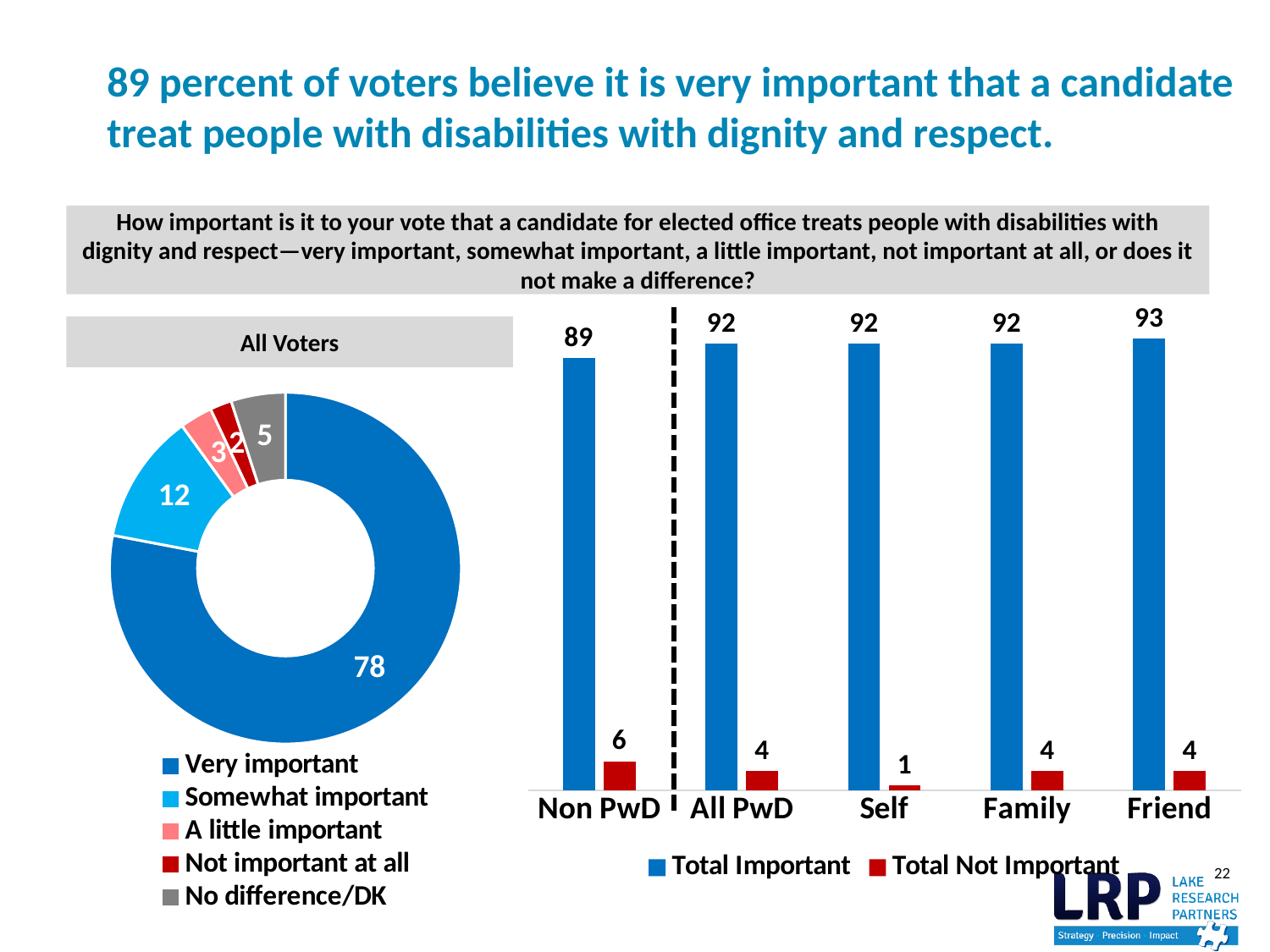
In the bar chart on the right, what is the Total Not Important value for Self? 1 In the bar chart on the right, what is the difference between the Total Important values for Friend and Non PwD? 4 What kind of chart is the All Voters chart on the left? Donut (pie) chart In the All Voters chart on the left, which category has the smallest slice? Not important at all In the bar chart on the right, is the Total Not Important value larger for Non PwD or for All PwD? Non PwD In the All Voters chart on the left, what value is shown for Somewhat important? 12 How many series does the legend of the bar chart on the right list? 2 In the bar chart on the right, which category has the highest Total Important value? Friend How many categories are shown on the x axis of the bar chart on the right? 5 In the All Voters chart on the left, what share is labelled for Very important? 78 In the bar chart on the right, what is the Total Important value for Non PwD? 89 In the bar chart on the right, which category has the lowest Total Not Important value? Self